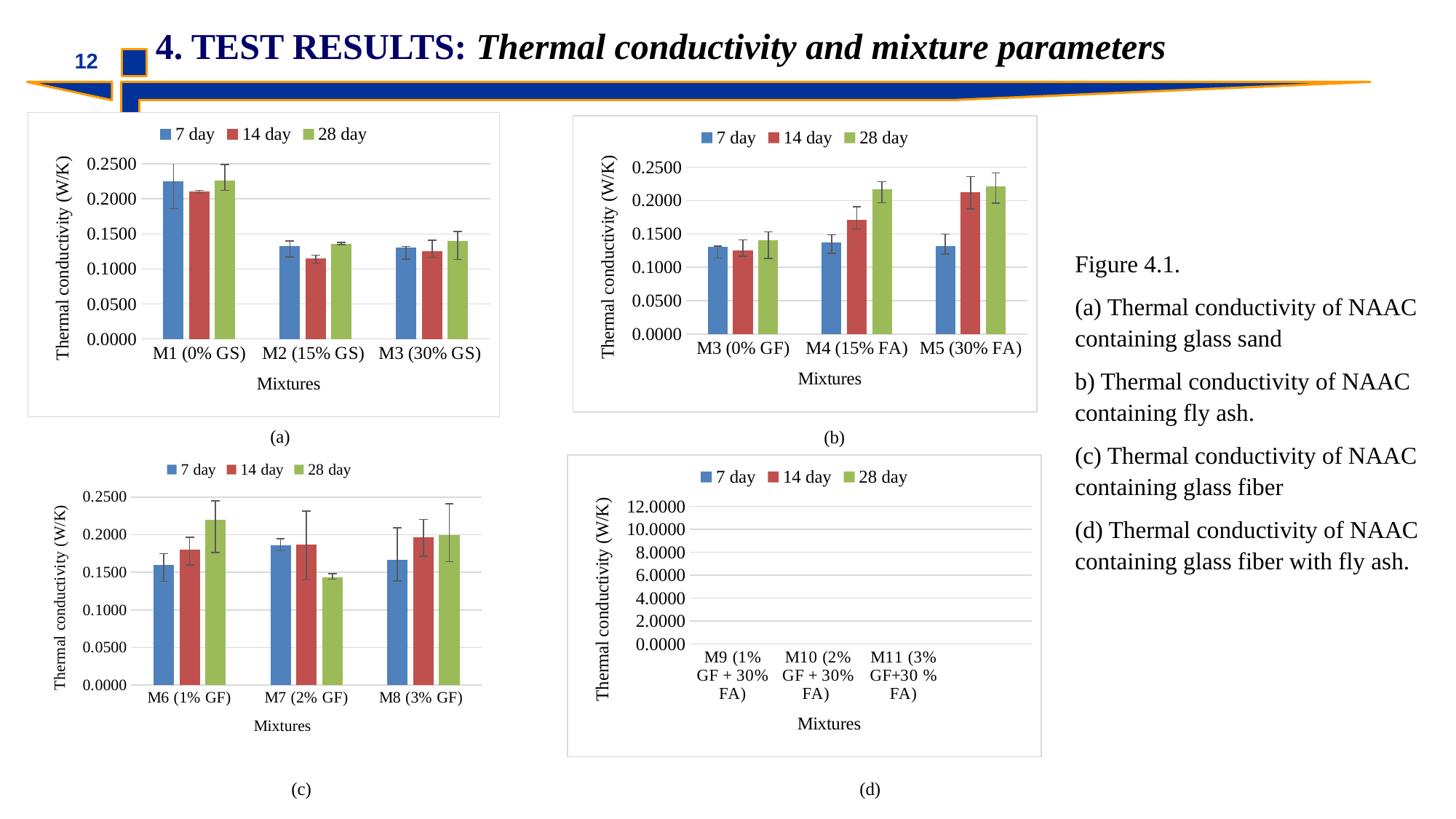
In chart (a), which mixture has the highest 7 day thermal conductivity? M1 (0% GS) In chart (a), is the 7 day value for M1 (0% GS) greater or less than 0.2000? greater What is the label of the y axis in chart (d)? Thermal conductivity (W/K) In chart (c), which mixture has the lowest 28 day thermal conductivity? M7 (2% GF) In chart (b), is the 28 day value for M4 (15% FA) greater or less than 0.2000? greater In chart (a), is the 14 day value for M2 (15% GS) greater or less than 0.1500? less In chart (b), which is larger for M4 (15% FA): the 7 day value or the 14 day value? 14 day How many series does the legend of chart (b) list? 3 How many mixture categories are shown on the x axis of chart (c)? 3 What kind of chart is chart (a), the top-left chart? bar chart In chart (b), does the 28 day thermal conductivity rise or fall from M3 (0% GF) to M5 (30% FA)? rise